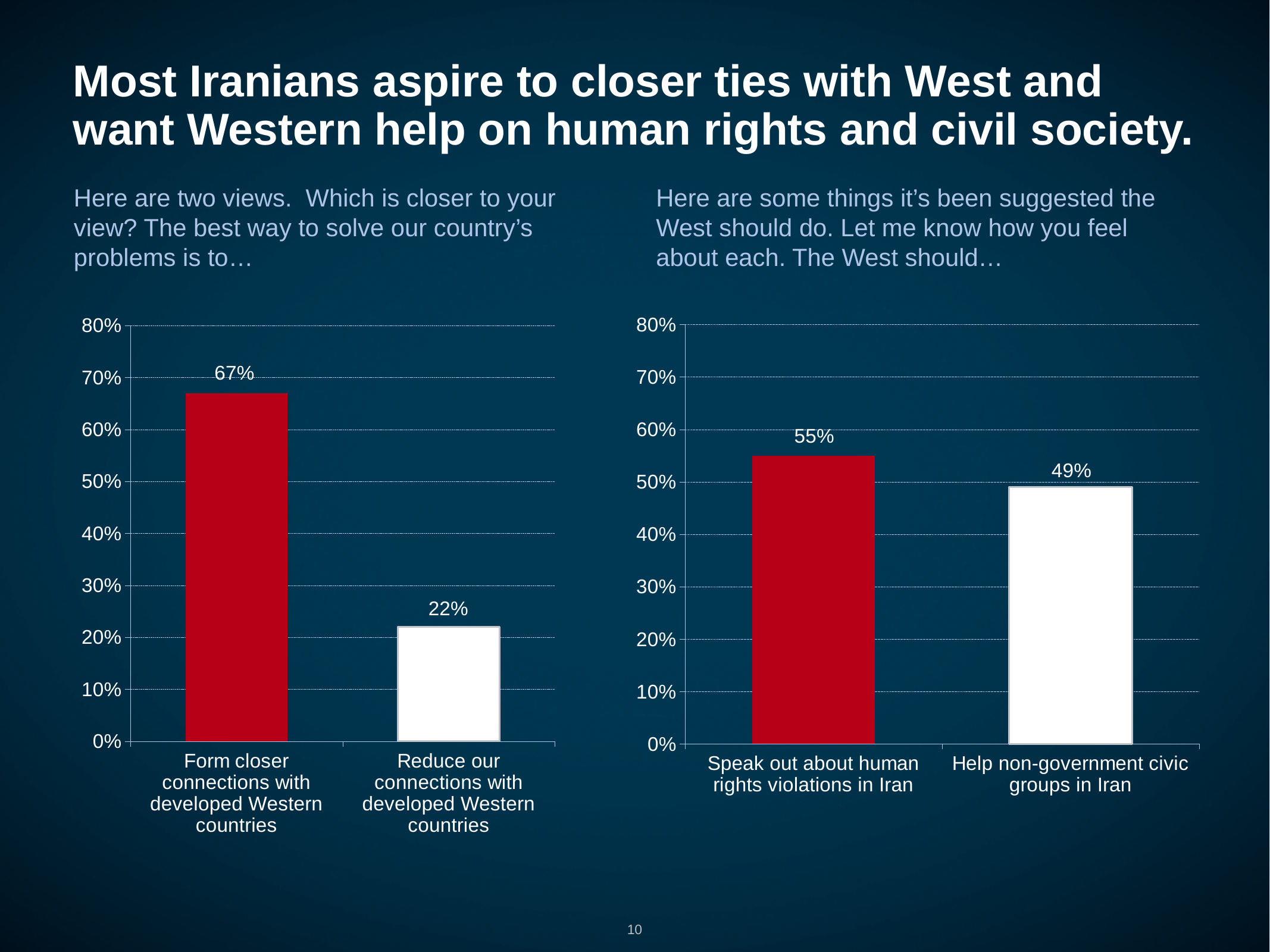
In the left chart, which category has the highest value? Form closer connections with developed Western countries In the left chart, what percentage chose 'Reduce our connections with developed Western countries'? 22% In the right chart, what is the value for 'Help non-government civic groups in Iran'? 49% In the right chart, which category has the lowest value? Help non-government civic groups in Iran In the right chart, which is larger: 'Speak out about human rights violations in Iran' or 'Help non-government civic groups in Iran'? Speak out about human rights violations in Iran In the right chart, what is the difference between 'Speak out about human rights violations in Iran' and 'Help non-government civic groups in Iran'? 6% In the left chart, what percentage chose 'Form closer connections with developed Western countries'? 67% How many bars are in the left chart? 2 What type of chart is the right chart? Bar chart In the right chart, what is the value for 'Speak out about human rights violations in Iran'? 55% In the left chart, what colour is the bar for 'Form closer connections with developed Western countries'? Red In the left chart, what is the difference between the two bars? 45%